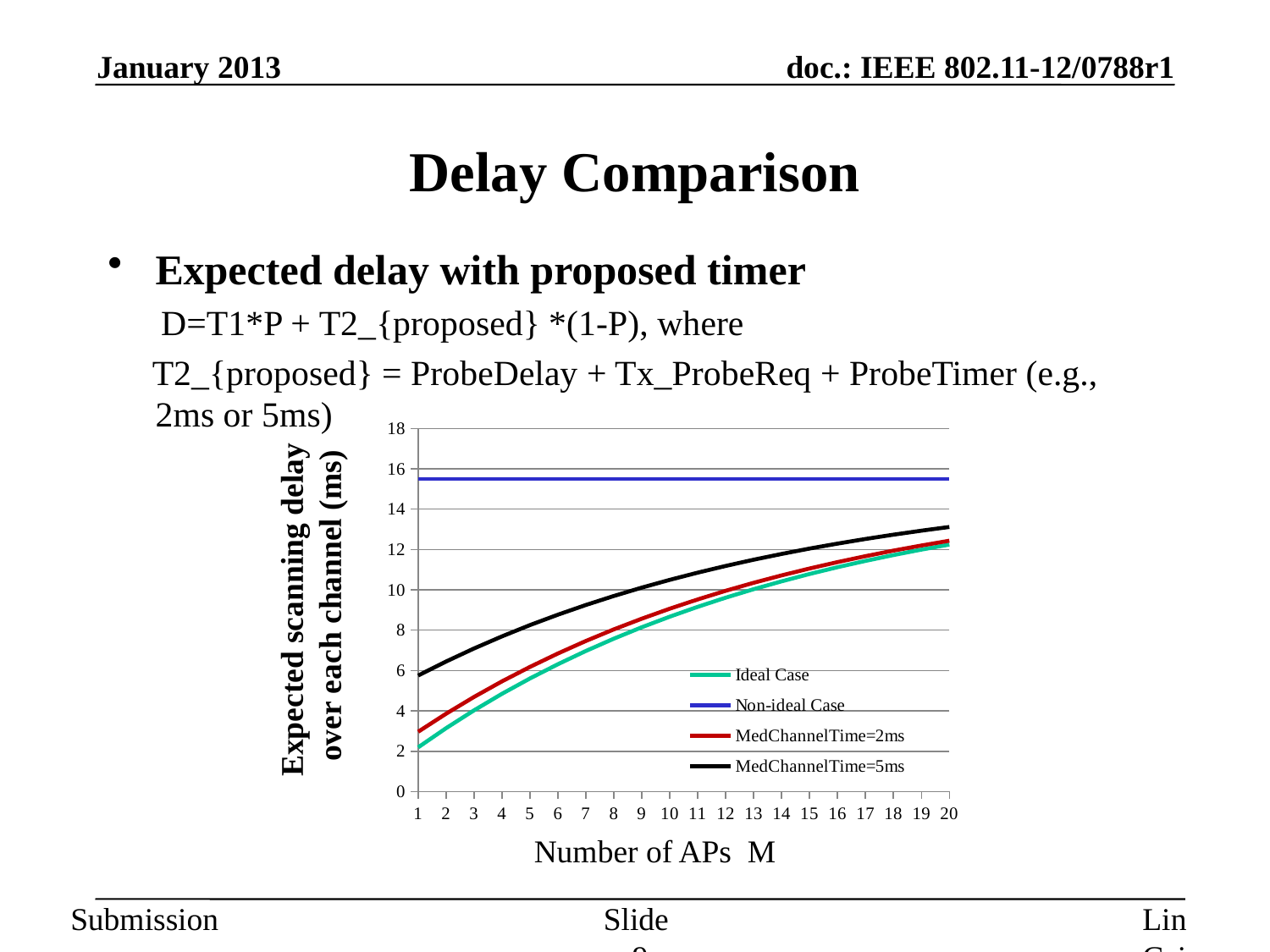
Does the Ideal Case series rise or fall as the number of APs M increases? rises At M = 1, which is larger: MedChannelTime=5ms or Ideal Case? MedChannelTime=5ms Which series has the lowest value at M = 5? Ideal Case Is the value for MedChannelTime=5ms at M = 20 greater or less than 12? greater How many values of M (Number of APs) are plotted along the x axis? 20 Is the value of the Non-ideal Case series greater or less than 14? greater Is the value for Ideal Case at M = 1 greater or less than 4? less Does the Non-ideal Case series rise, fall, or stay flat as the number of APs M increases? stays flat How many series does the chart legend list? 4 Which series has the highest value at M = 10? Non-ideal Case What is the label of the x axis of the chart? Number of APs M What kind of chart is shown on the slide? line chart